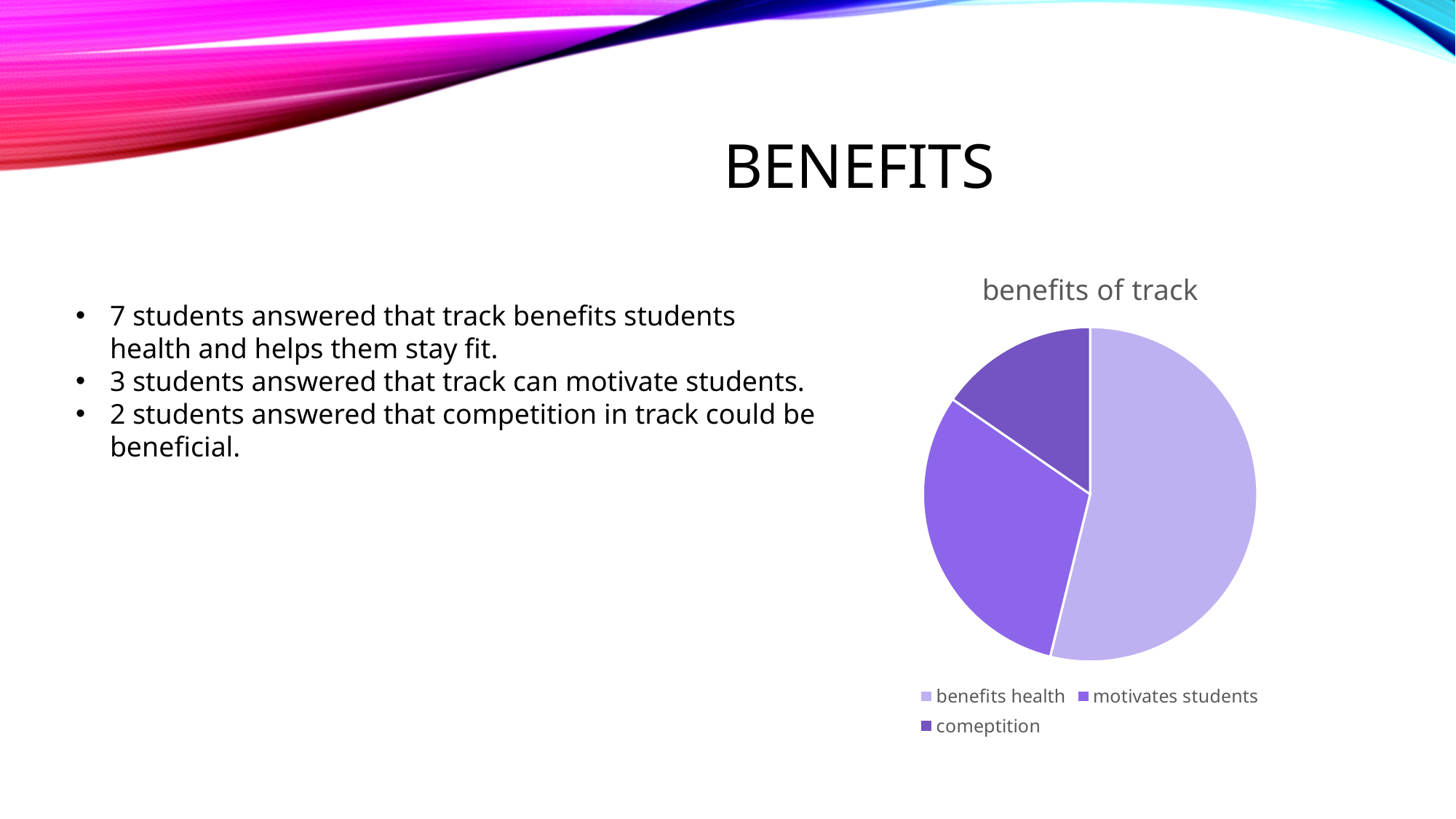
What kind of chart is shown on the slide? pie chart What is the title of the chart? benefits of track Which category has the largest slice of the pie? benefits health Which slice is larger, motivates students or comeptition? motivates students How many entries does the chart legend list? 3 Is the benefits health slice greater or less than half of the pie? greater Which category has the smallest slice of the pie? comeptition How many slices does the pie chart have? 3 Which slice is larger, benefits health or motivates students? benefits health Which legend entry is shown in the lightest shade of purple? benefits health